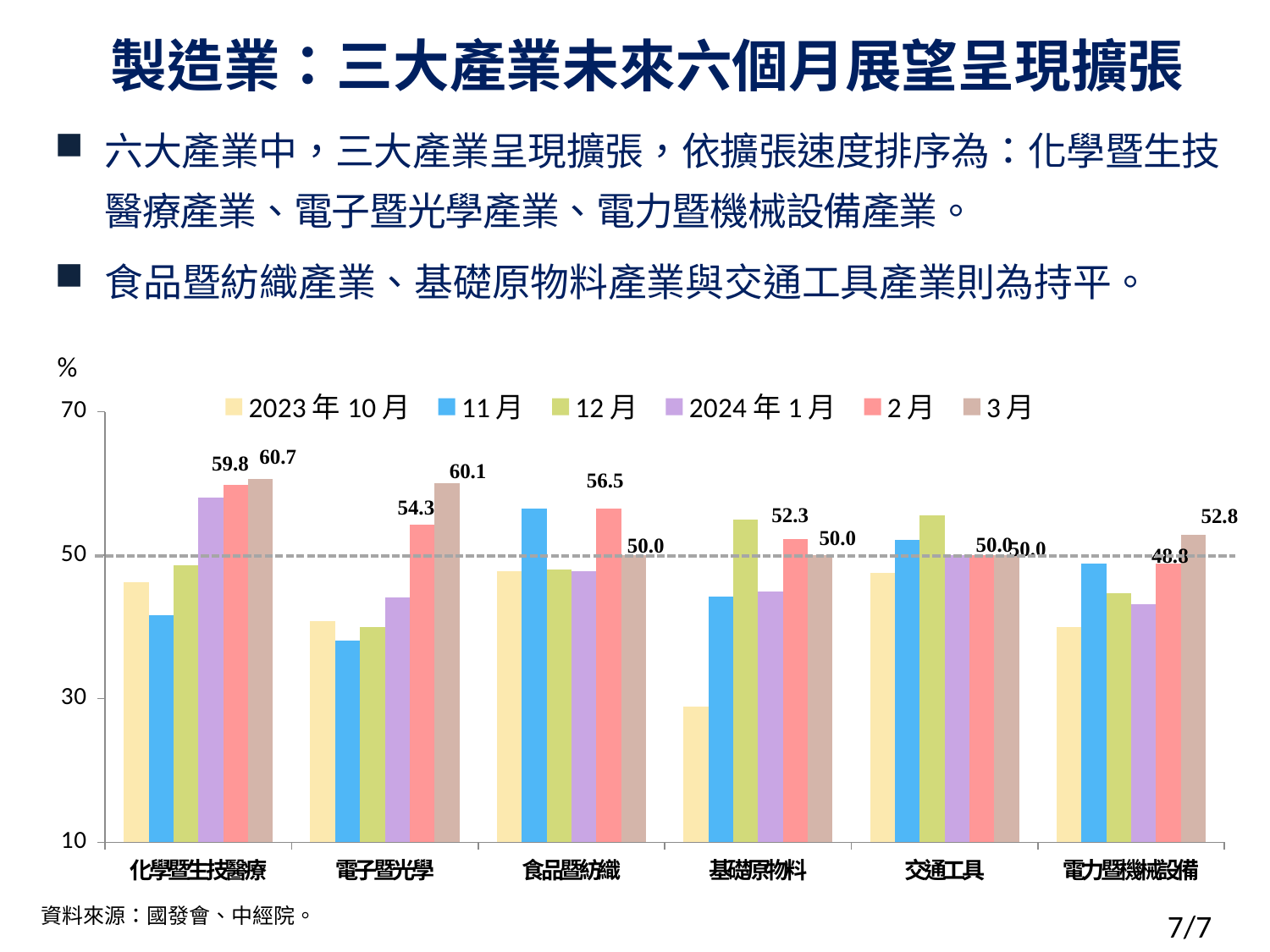
How many series does the legend list? 6 Which is larger for 基礎原物料: the 2月 value or the 3月 value? 2月 What is the value for 食品暨紡織 in 2月? 56.5 Which industry has the lowest value in 2月? 電力暨機械設備 Which industry has the highest value in 2月? 化學暨生技醫療 What is the value for 化學暨生技醫療 in 3月? 60.7 Is the value for 基礎原物料 in 2023年10月 greater or less than 30? less How many industry categories are shown on the x axis? 6 What is the value for 電力暨機械設備 in 3月? 52.8 What is the value for 電子暨光學 in 2月? 54.3 What is the difference between the 3月 and 2月 values for 電子暨光學? 5.8 What kind of chart is shown on the slide? bar chart